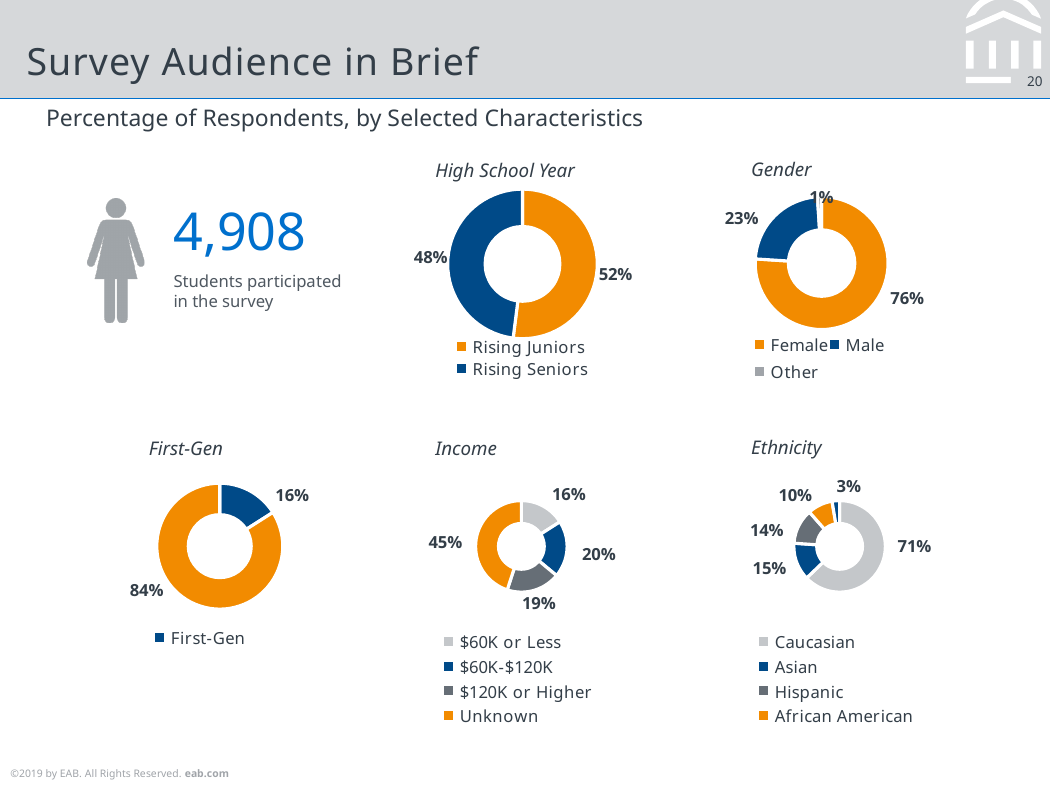
How many categories does the Gender chart's legend list? 3 In the High School Year chart, what percentage of respondents are Rising Juniors? 52% What kind of chart is used for the High School Year breakdown? Donut (pie) chart In the Gender chart, what percentage of respondents are Female? 76% In the Income chart, what percentage of respondents have an Unknown income? 45% How many categories does the Ethnicity chart's legend list? 4 In the First-Gen chart, what percentage of respondents are First-Gen? 16% In the Gender chart, which category has the smallest share? Other In the Income chart, which is larger: the share for $60K-$120K or the share for $120K or Higher? $60K-$120K In the Ethnicity chart, what percentage of respondents are Caucasian? 71% In the High School Year chart, what is the difference between the Rising Juniors and Rising Seniors percentages? 4% In the Income chart, which category has the largest share? Unknown